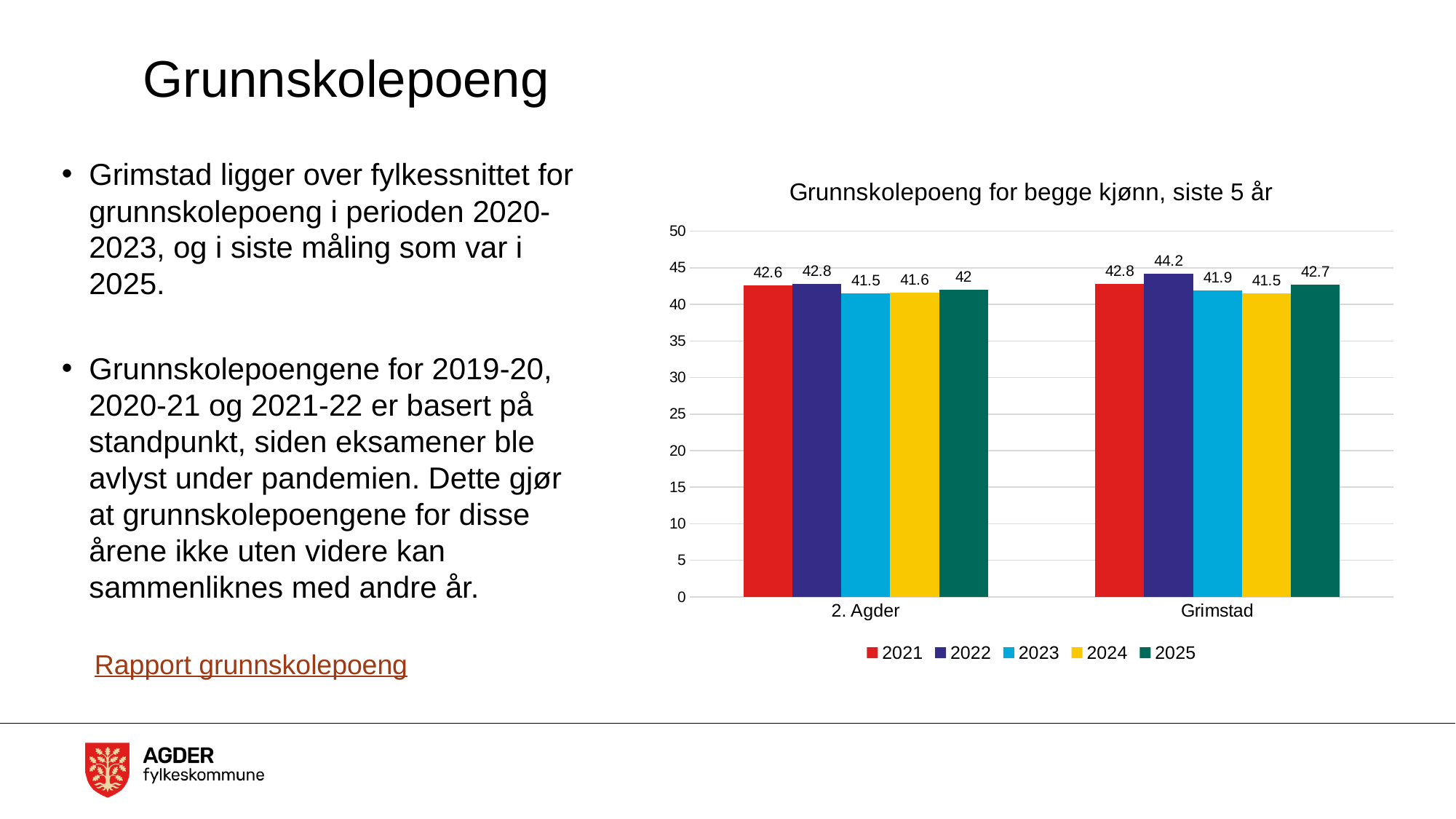
Which year has the highest value for Grimstad? 2022 Which year has the lowest value for 2. Agder? 2023 What kind of chart is shown? Bar chart What is the value for Grimstad in 2022? 44.2 What is the difference between Grimstad and 2. Agder in 2022? 1.4 How many categories are shown on the x axis? 2 What is the value for 2. Agder in 2021? 42.6 What is the value for Grimstad in 2024? 41.5 How many series does the legend list? 5 Which is larger in 2025, 2. Agder or Grimstad? Grimstad What is the value for 2. Agder in 2025? 42 What is the title of the chart? Grunnskolepoeng for begge kjønn, siste 5 år